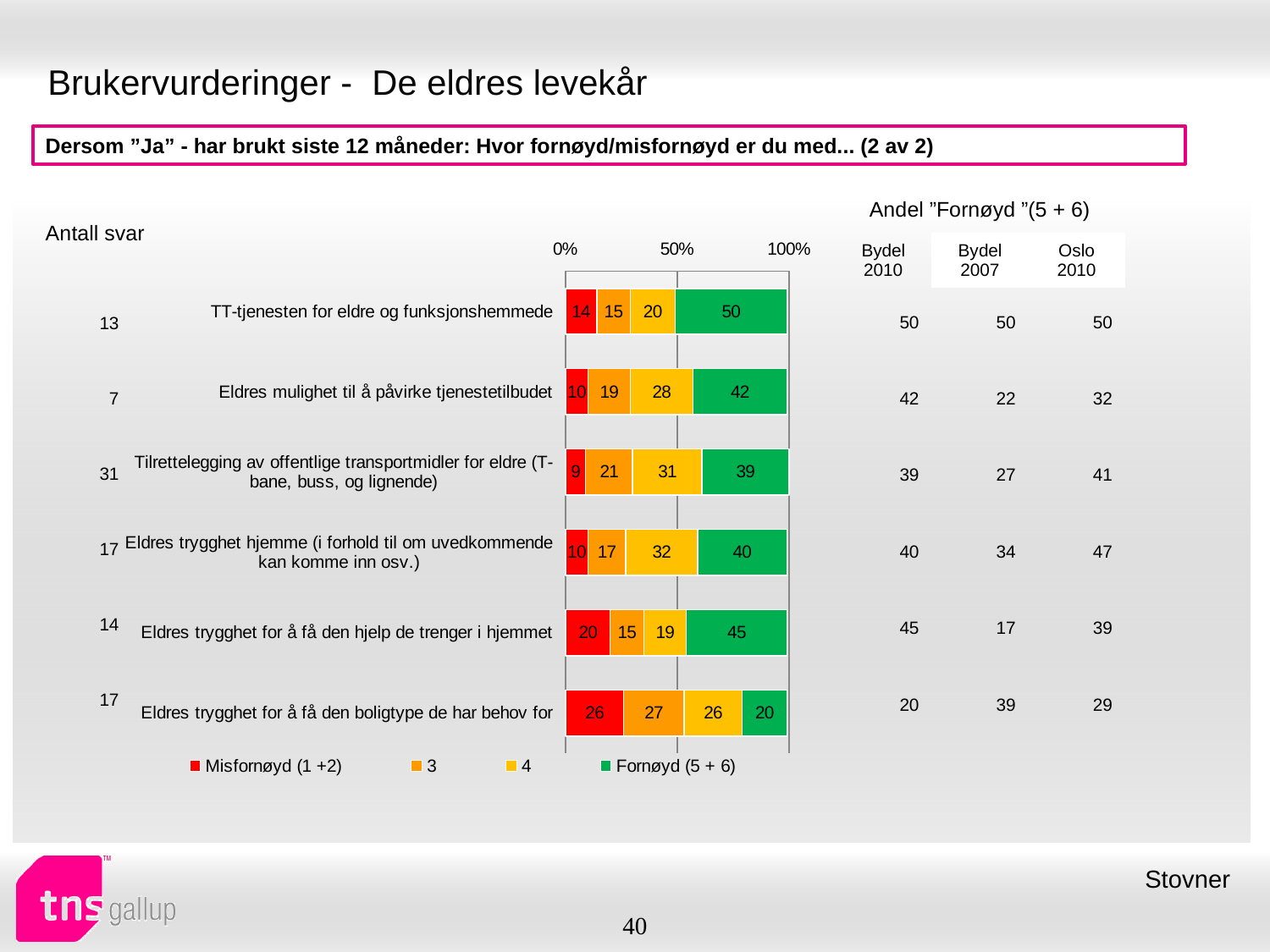
How many series does the chart legend list? 4 Which category has the lowest 'Fornøyd (5 + 6)' value? Eldres trygghet for å få den boligtype de har behov for What is the 'Misfornøyd (1 +2)' value for 'Eldres trygghet for å få den boligtype de har behov for'? 26 Which has a larger 'Misfornøyd (1 +2)' value: 'Eldres trygghet for å få den hjelp de trenger i hjemmet' or 'TT-tjenesten for eldre og funksjonshemmede'? Eldres trygghet for å få den hjelp de trenger i hjemmet What is the 'Fornøyd (5 + 6)' value for 'TT-tjenesten for eldre og funksjonshemmede'? 50 What kind of chart is shown on the slide? Stacked bar chart What colour represents the 'Fornøyd (5 + 6)' series in the chart? Green What is the value of series '3' for 'Tilrettelegging av offentlige transportmidler for eldre (T-bane, buss, og lignende)'? 21 How many categories (questions) are plotted in the chart? 6 What is the difference between the 'Fornøyd (5 + 6)' values for 'Eldres trygghet for å få den hjelp de trenger i hjemmet' and 'Eldres mulighet til å påvirke tjenestetilbudet'? 3 What is the value of series '4' for 'Eldres trygghet hjemme (i forhold til om uvedkommende kan komme inn osv.)'? 32 Which category has the highest 'Fornøyd (5 + 6)' value? TT-tjenesten for eldre og funksjonshemmede